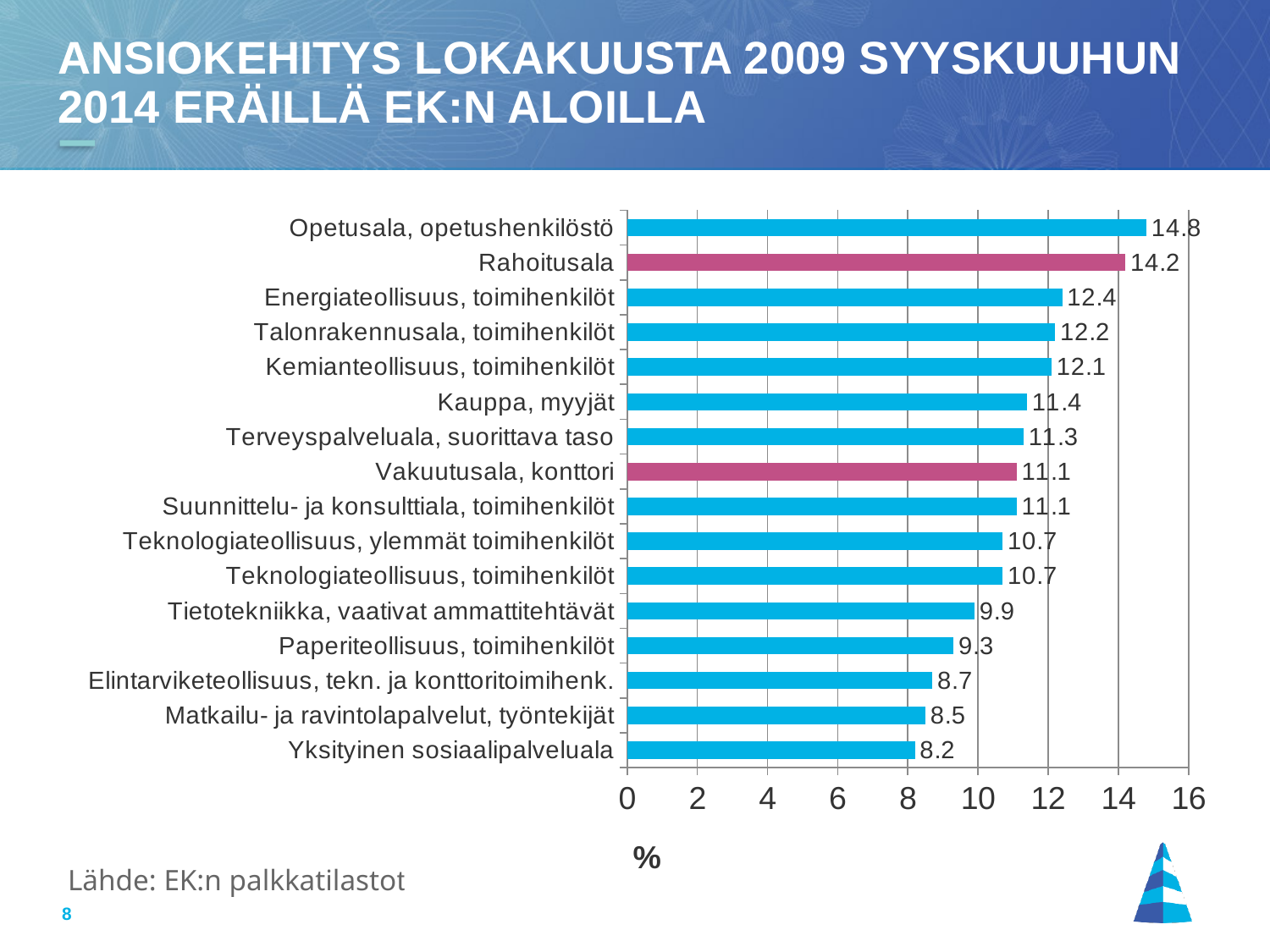
What is the value for Paperiteollisuus, toimihenkilöt? 9.3 What unit is shown on the horizontal axis of the chart? % Which category has the lowest value? Yksityinen sosiaalipalveluala Which category has the highest value? Opetusala, opetushenkilöstö What kind of chart is shown on the slide? Bar chart What is the value for Kauppa, myyjät? 11.4 Which two categories are drawn in a different colour (pink) from the rest? Rahoitusala and Vakuutusala, konttori Which is larger, the value for Energiateollisuus, toimihenkilöt or the value for Tietotekniikka, vaativat ammattitehtävät? Energiateollisuus, toimihenkilöt Is the value for Matkailu- ja ravintolapalvelut, työntekijät greater or less than 10? less What is the value for Rahoitusala? 14.2 How many categories are shown in the chart? 16 What is the difference between the values for Opetusala, opetushenkilöstö and Yksityinen sosiaalipalveluala? 6.6